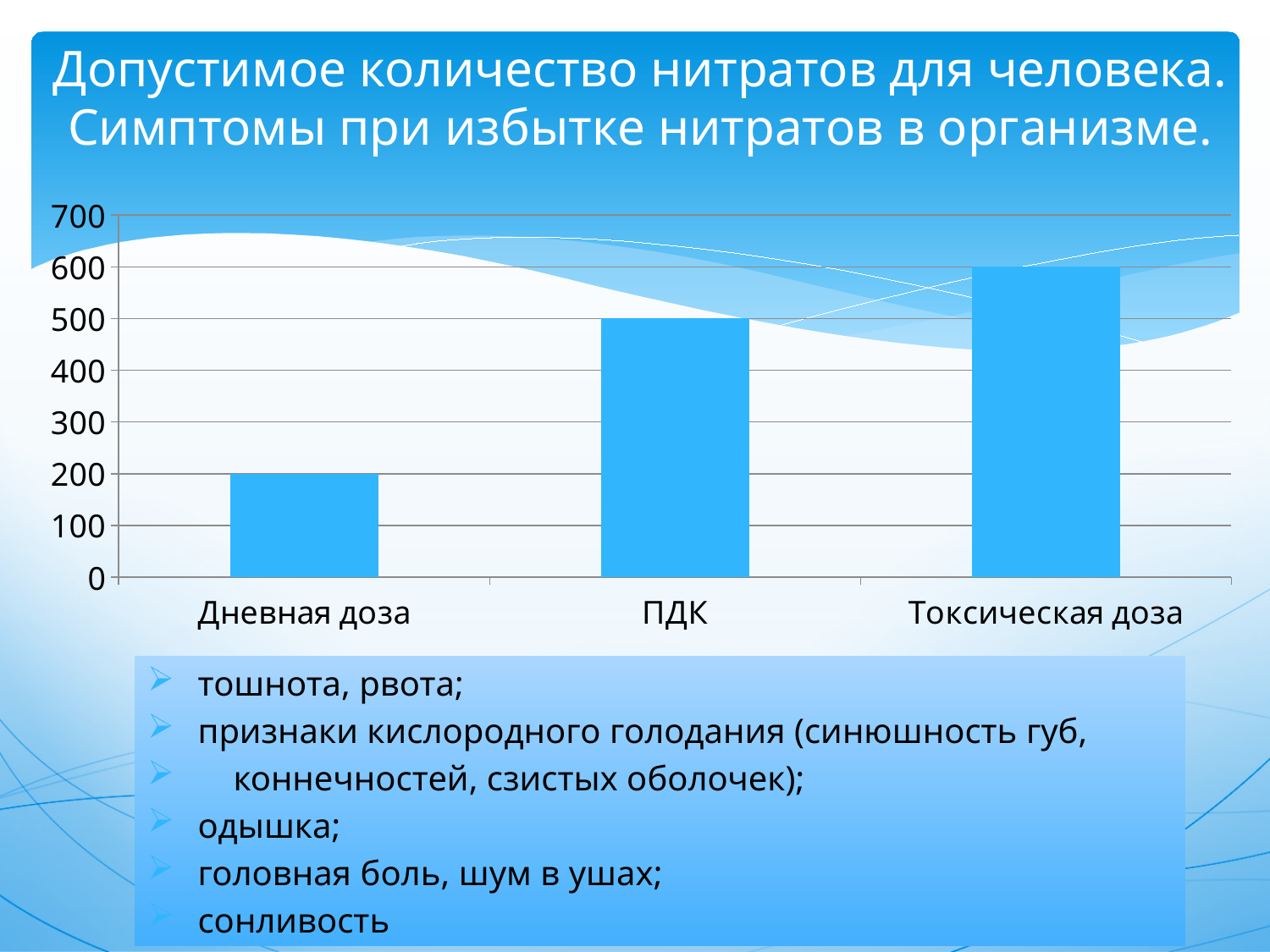
What is the highest value shown on the vertical axis? 700 What is the value for ПДК? 500 Which category has the highest value? Токсическая доза Do the values rise or fall from left to right along the x axis? rise What is the difference between the values for Токсическая доза and Дневная доза? 400 What is the value for Дневная доза? 200 What kind of chart is shown on the slide? bar chart What is the difference between the values for ПДК and Дневная доза? 300 How many categories are plotted on the chart? 3 What is the value for Токсическая доза? 600 Which category has the lowest value? Дневная доза Which is larger, the value for ПДК or the value for Дневная доза? ПДК